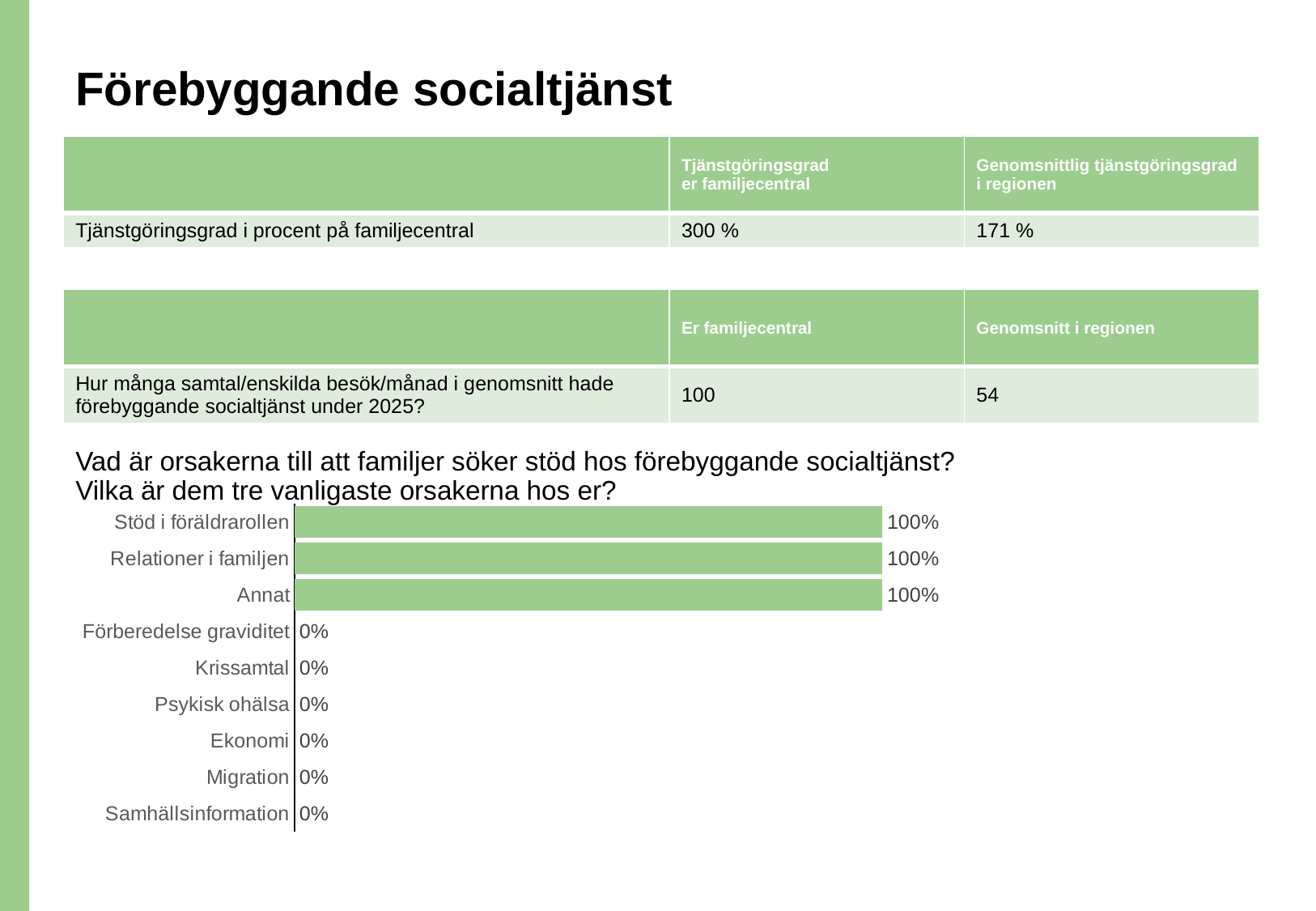
What is the value for Krissamtal in the bar chart? 0% What kind of chart is shown at the bottom of the slide? bar chart What is the value for Samhällsinformation in the bar chart? 0% In the bar chart, what is the difference between the values for Relationer i familjen and Migration? 100% Which category is listed first (at the top) in the bar chart? Stöd i föräldrarollen How many categories in the bar chart have a value of 100%? 3 What is the value for Annat in the bar chart? 100% How many categories does the bar chart list? 9 In the bar chart, which is larger: Annat or Ekonomi? Annat What is the value for Relationer i familjen in the bar chart? 100% What is the value for Psykisk ohälsa in the bar chart? 0% What is the value for Stöd i föräldrarollen in the bar chart? 100%